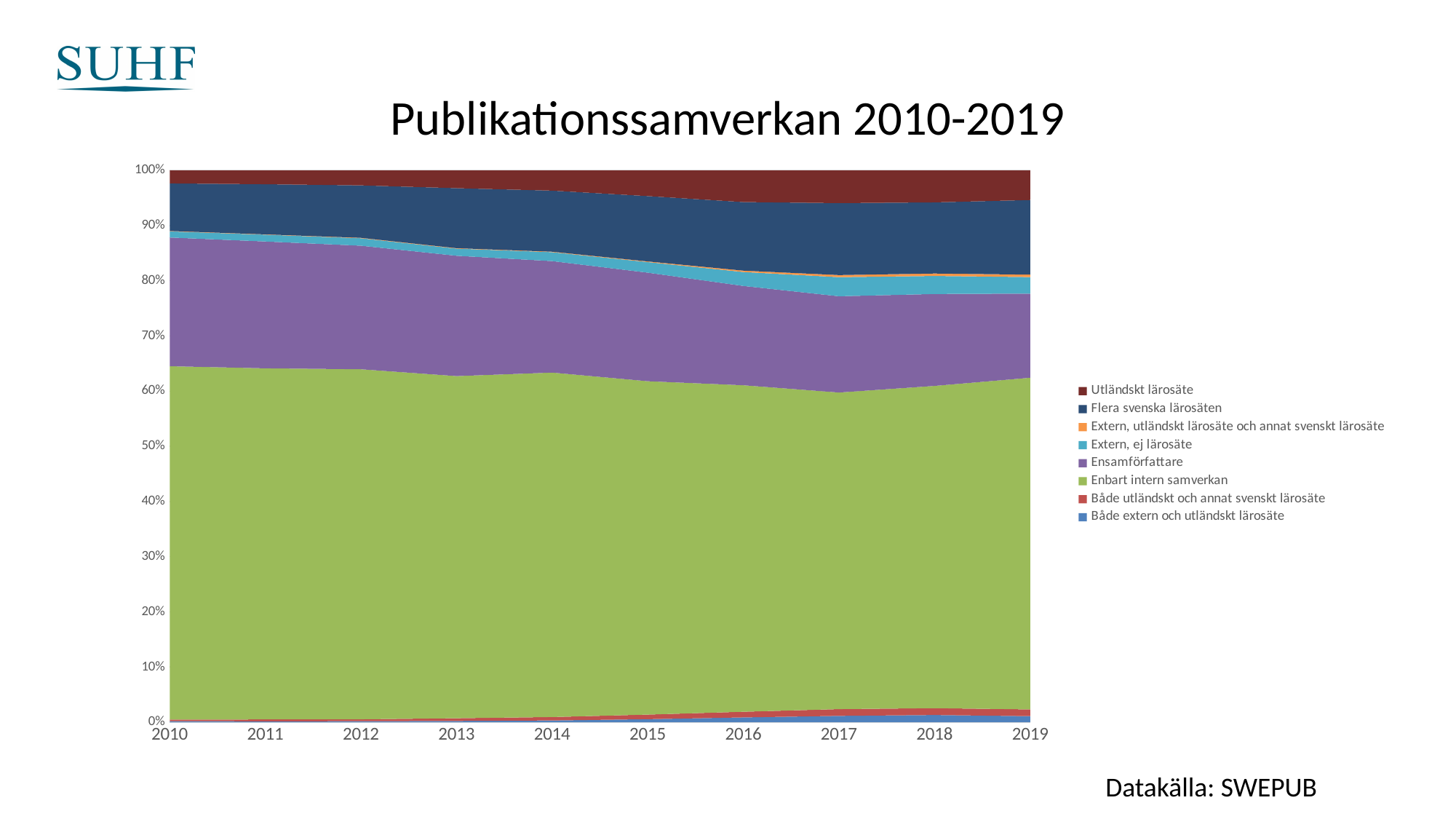
Does the share of Ensamförfattare rise or fall from 2010 to 2019? fall Does the share of Flera svenska lärosäten rise or fall from 2010 to 2019? rise What kind of chart is shown on the slide? Stacked area chart Is the value for Enbart intern samverkan in 2010 greater or less than 60%? greater How many years are plotted along the x axis? 10 Which series is shown at the top of the stacked areas? Utländskt lärosäte Which is larger in 2019, Enbart intern samverkan or Ensamförfattare? Enbart intern samverkan Does the share of Utländskt lärosäte rise or fall from 2010 to 2019? rise How many series does the legend list? 8 What is the title of the chart? Publikationssamverkan 2010-2019 Is the value for Enbart intern samverkan in 2019 greater or less than 50%? greater Which series takes up the largest share of the chart? Enbart intern samverkan